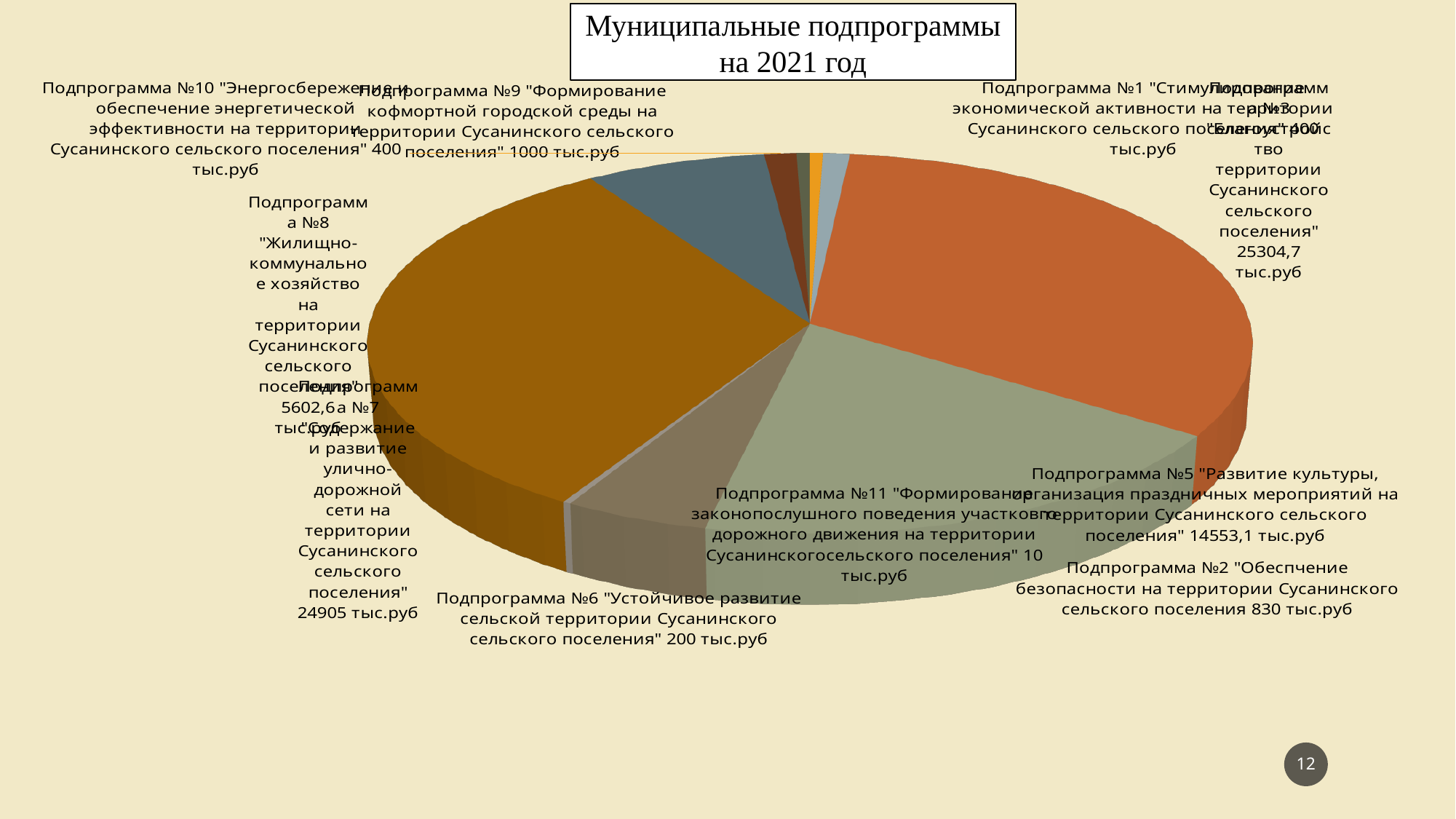
What kind of chart is shown on the slide? pie chart What is the value for Подпрограмма №8 "Жилищно-коммунальное хозяйство"? 5602,6 тыс.руб Which is larger: the value for Подпрограмма №9 or Подпрограмма №2? Подпрограмма №9 What is the difference between the values for Подпрограмма №3 and Подпрограмма №7? 399,7 тыс.руб What is the value for Подпрограмма №2 "Обеспечение безопасности"? 830 тыс.руб What is the value for Подпрограмма №3 "Благоустройство территории Сусанинского сельского поселения"? 25304,7 тыс.руб Which subprogram has the largest value in the pie chart? Подпрограмма №3 "Благоустройство территории Сусанинского сельского поселения" What is the title of the chart? Муниципальные подпрограммы на 2021 год Which subprogram has the smallest value in the pie chart? Подпрограмма №11 "Формирование законопослушного поведения участников дорожного движения" What is the value for Подпрограмма №7 "Содержание и развитие улично-дорожной сети"? 24905 тыс.руб What is the difference between the values for Подпрограмма №5 and Подпрограмма №8? 8950,5 тыс.руб What is the value for Подпрограмма №5 "Развитие культуры, организация праздничных мероприятий"? 14553,1 тыс.руб